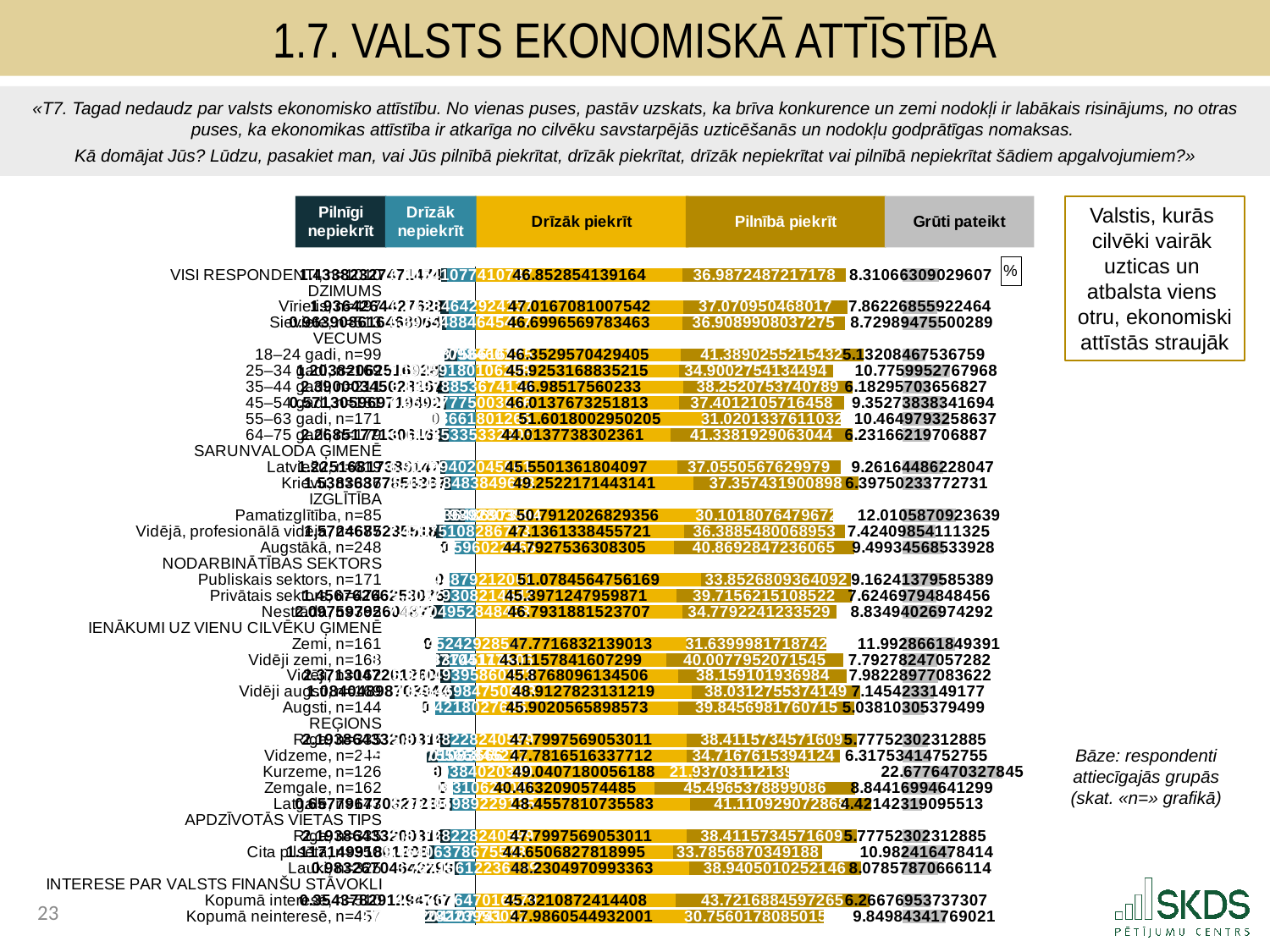
Which has the larger 'Pilnībā piekrīt' value: Kurzeme, n=126 or Zemgale, n=162? Zemgale, n=162 What is the 'Grūti pateikt' value for Kurzeme, n=126? 22.6776470327845 What is the 'Pilnībā piekrīt' value for Kurzeme, n=126? 21.93703112139 Which legend entry is shown in the darkest blue-grey colour? Pilnīgi nepiekrīt Which region has the lowest 'Pilnībā piekrīt' value? Kurzeme, n=126 What is the 'Drīzāk piekrīt' value for 55–63 gadi, n=171? 51.6018002950205 What kind of chart is shown on the slide? Stacked bar chart Which region has the highest 'Grūti pateikt' value? Kurzeme, n=126 How many regions are listed under REĢIONS? 5 What is the 'Drīzāk piekrīt' value for VISI RESPONDENTI? 46.852854139164 How many series does the legend list? 5 What is the 'Pilnībā piekrīt' value for Zemgale, n=162? 45.4965378899086